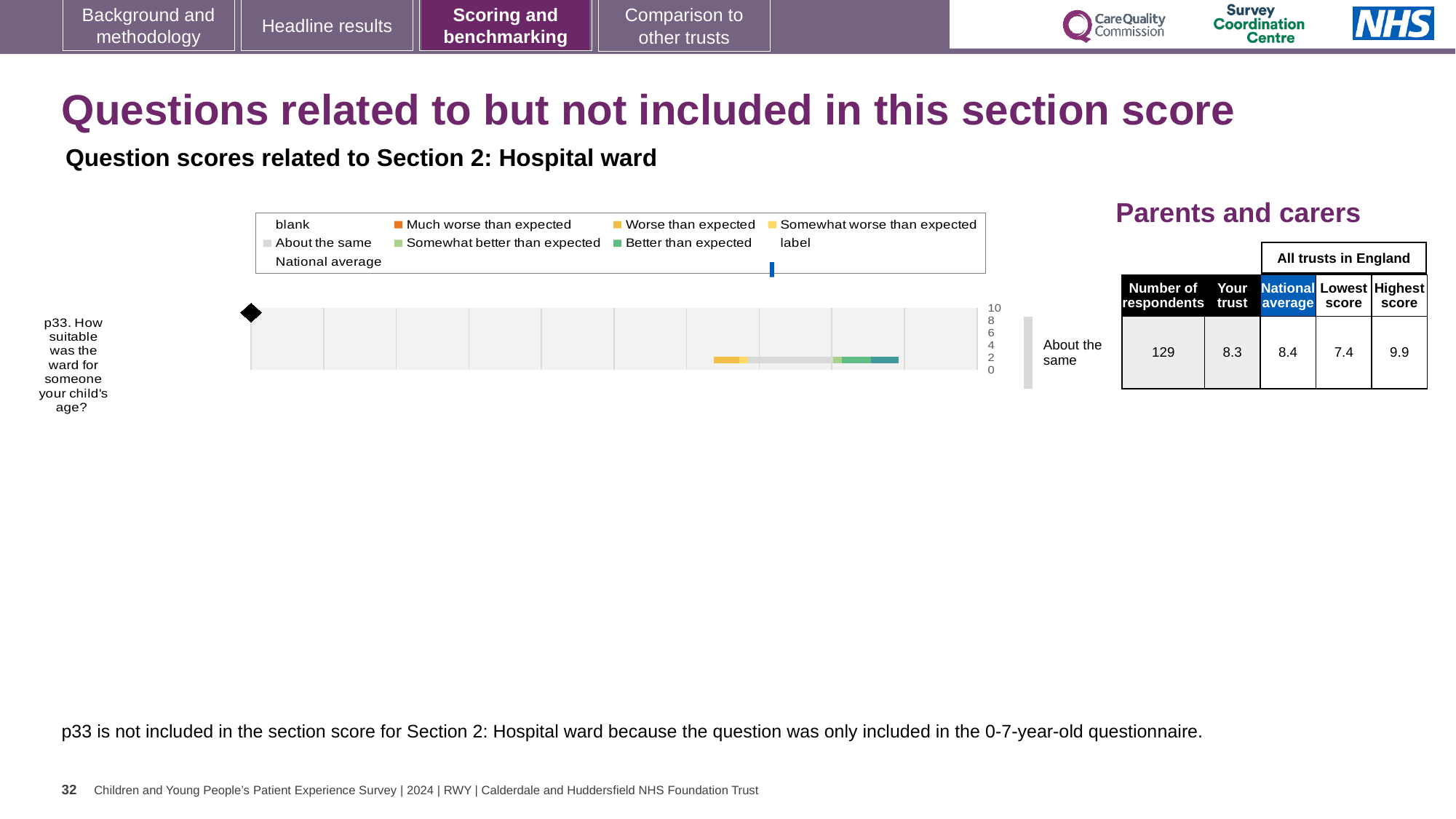
How many entries does the chart legend list? 9 In the table beside the chart, how many respondents are listed for p33? 129 Which legend entry is shown in orange? Much worse than expected In the table beside the chart, what is the difference between the national average and the 'Your trust' score for p33? 0.1 In the table beside the chart, which is larger for p33: the 'Your trust' score or the national average? National average What kind of chart is shown on the slide for question p33? bar chart In the table beside the chart, what is the national average score for p33? 8.4 What is the highest value shown on the chart's axis? 10 What benchmark result label is shown next to the bar for p33? About the same How many questions (categories) are plotted in the chart? 1 In the table beside the chart, what is the difference between the highest score and the lowest score for p33? 2.5 In the table beside the chart, what is the 'Your trust' score for p33? 8.3